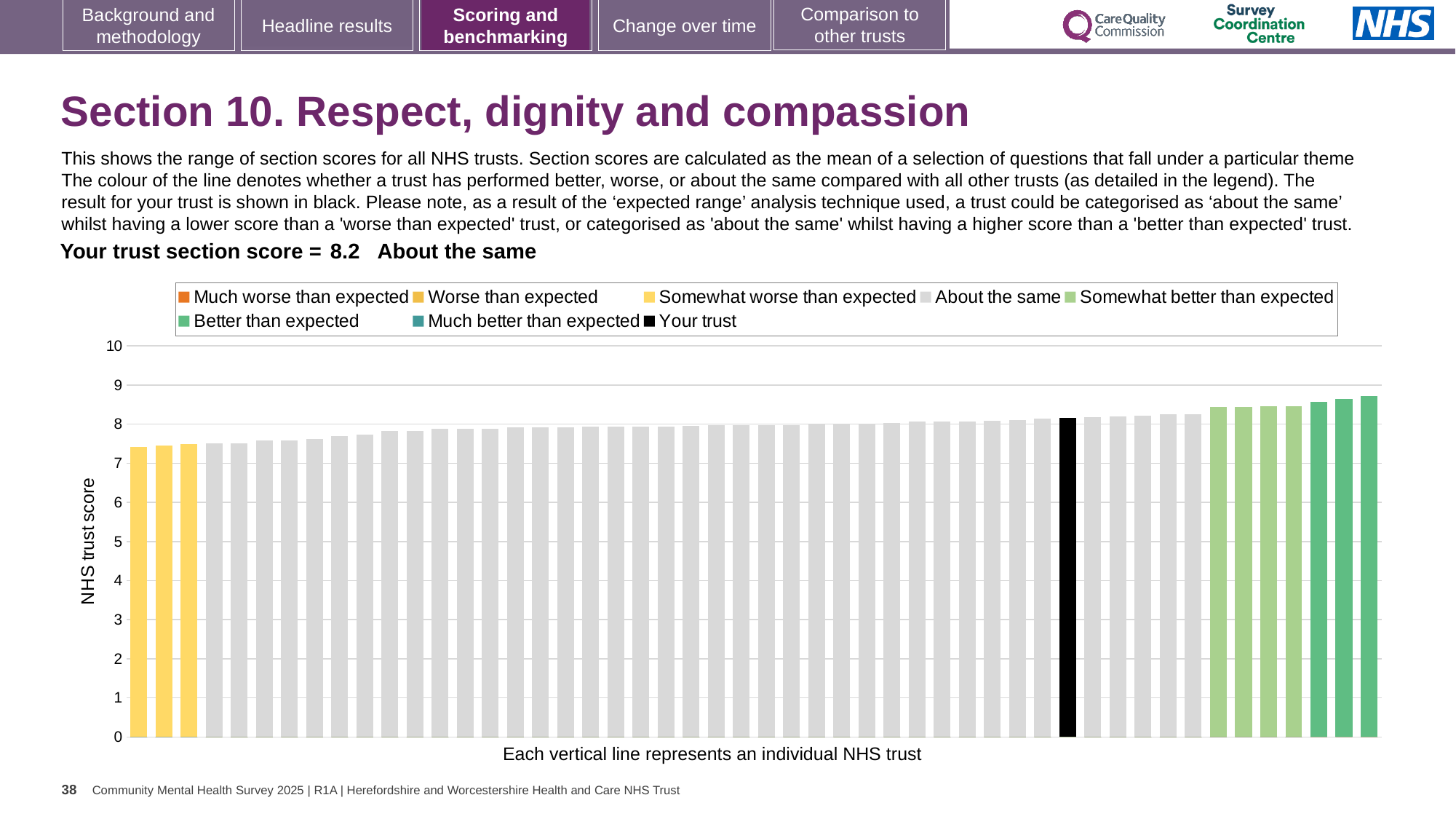
How many green bars are there at the right of the chart? 7 How is your trust's score categorised compared with other trusts? About the same How many entries does the chart legend list? 8 Which is larger: the black bar for your trust or the leftmost yellow bar? the black bar for your trust What is the section score for your trust shown on the slide? 8.2 Is the value of the black bar (your trust) greater or less than 8? greater What is the label on the vertical axis of the chart? NHS trust score How many yellow bars are there at the left of the chart? 3 Do the bar values rise or fall from left to right along the x axis? rise What kind of chart is shown on the slide? bar chart Is the value of the rightmost (highest) bar greater or less than 9? less Is the value of the leftmost bar greater or less than 8? less